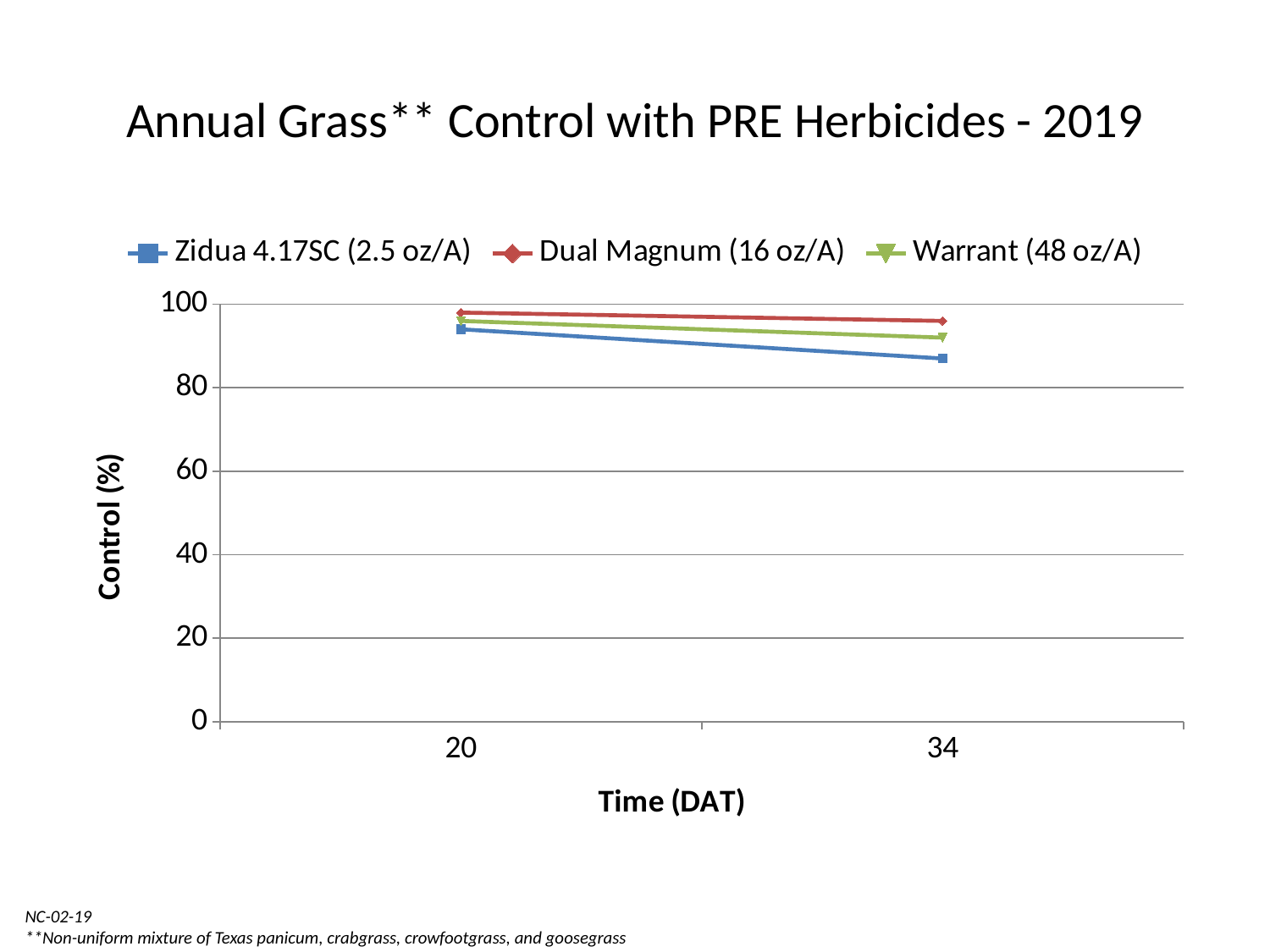
How many series does the legend list? 3 At 34 DAT, which is larger: the control for Warrant (48 oz/A) or for Zidua 4.17SC (2.5 oz/A)? Warrant (48 oz/A) Which series has the lowest control at 34 DAT? Zidua 4.17SC (2.5 oz/A) Does the control for Zidua 4.17SC (2.5 oz/A) rise or fall from 20 DAT to 34 DAT? fall What is the title of the chart? Annual Grass** Control with PRE Herbicides - 2019 Does the control for Warrant (48 oz/A) rise or fall from 20 DAT to 34 DAT? fall Which series has the highest control at 34 DAT? Dual Magnum (16 oz/A) Is the value for Zidua 4.17SC (2.5 oz/A) at 34 DAT greater or less than 80? greater What type of chart is shown on the slide? line chart Is the value for Dual Magnum (16 oz/A) at 20 DAT greater or less than 80? greater What is the label of the y axis? Control (%) How many time points are plotted on the x axis? 2